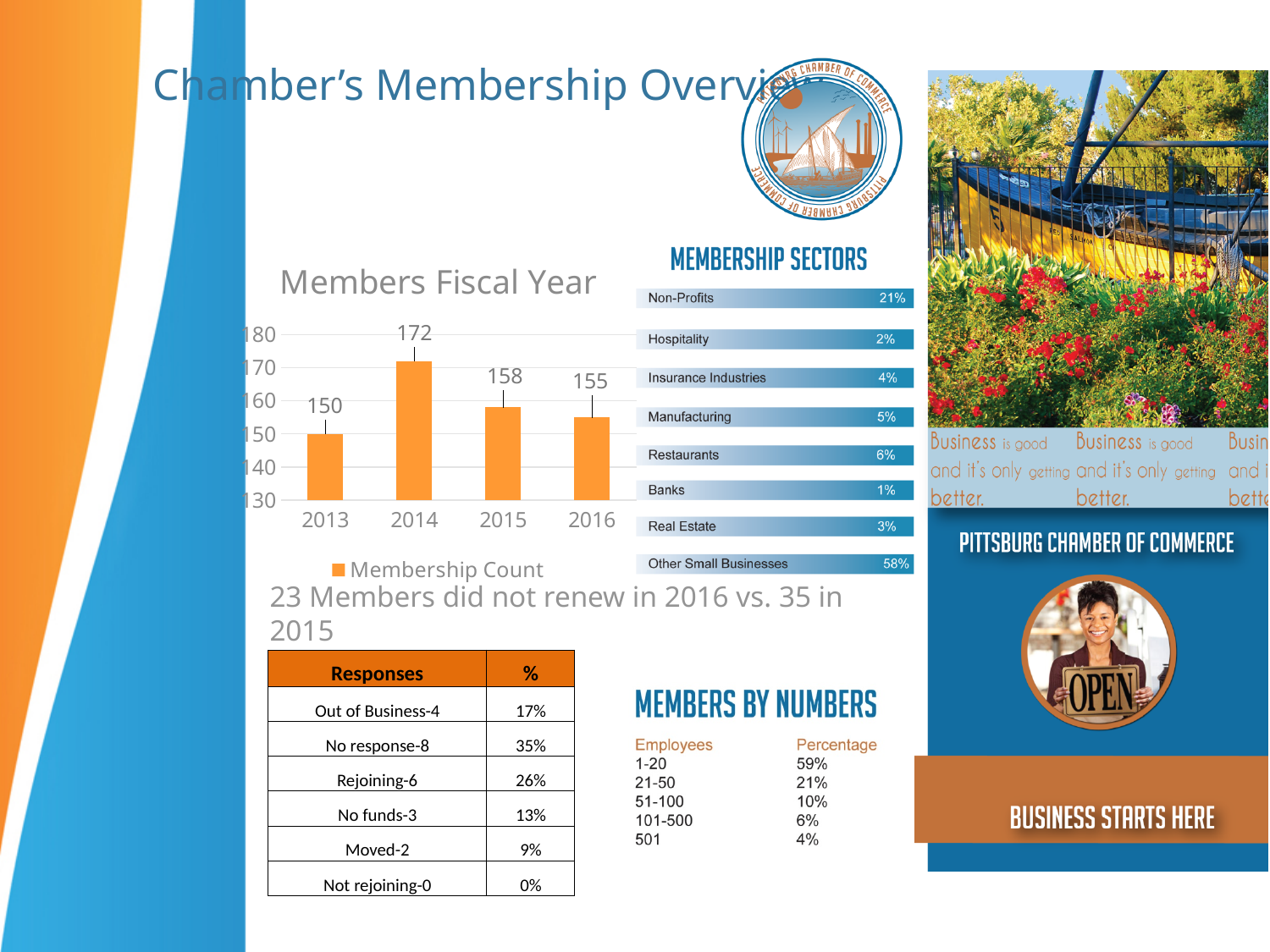
What is the legend entry of the Members Fiscal Year chart? Membership Count In the Members Fiscal Year chart, which year has the highest membership count? 2014 In the Members Fiscal Year chart, what is the membership count for 2016? 155 In the Members Fiscal Year chart, what is the membership count for 2013? 150 In the Members Fiscal Year chart, what is the difference between the membership counts for 2014 and 2015? 14 In the Members Fiscal Year chart, which year has a larger membership count, 2015 or 2016? 2015 How many years are shown on the x axis of the Members Fiscal Year chart? 4 In the Members Fiscal Year chart, what is the membership count for 2014? 172 How many series does the legend of the Members Fiscal Year chart list? 1 In the Members Fiscal Year chart, is the value for 2014 greater or less than 170? greater What kind of chart is the Members Fiscal Year chart? Bar chart In the Members Fiscal Year chart, which year has the lowest membership count? 2013